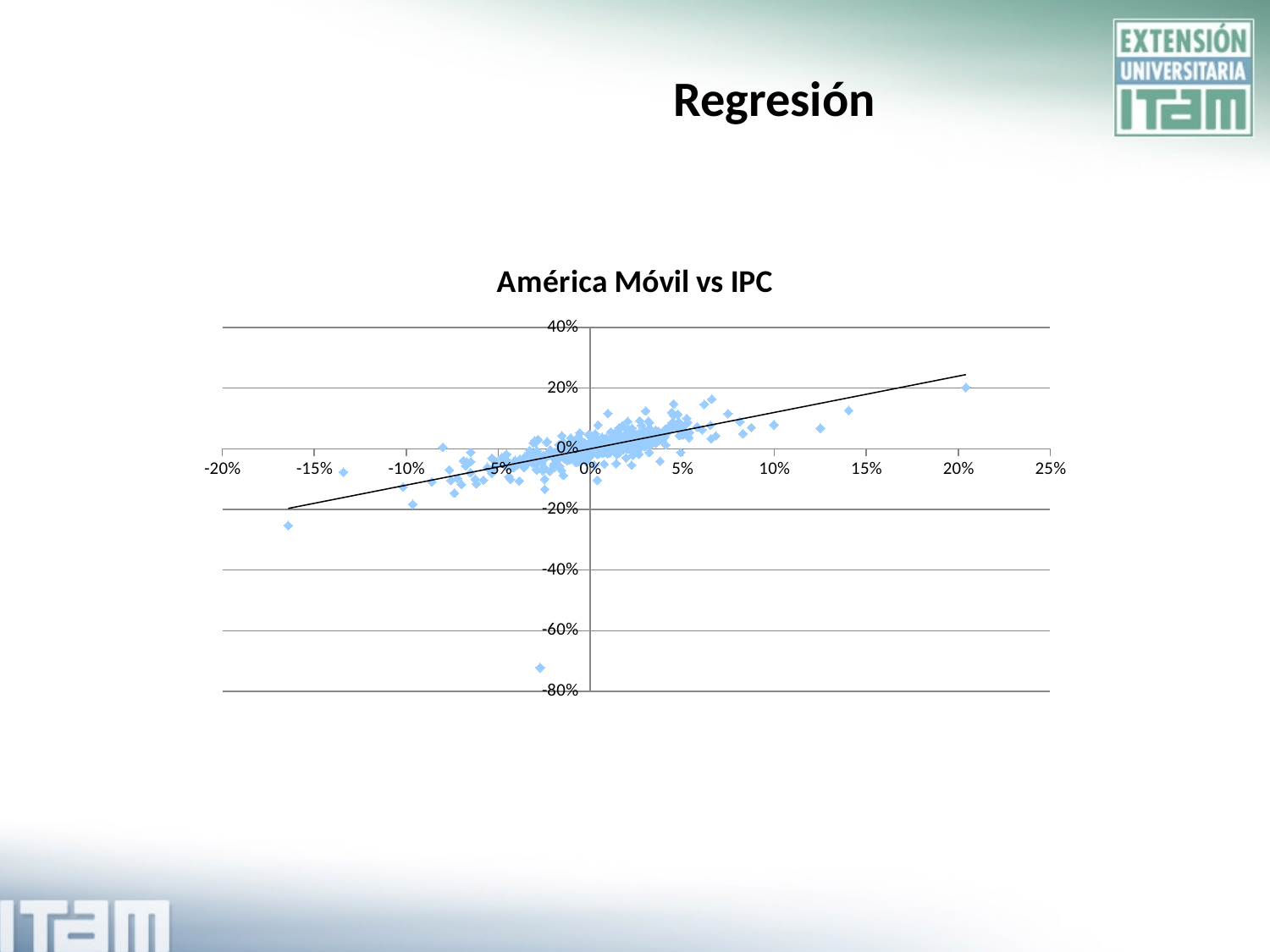
Is the y value of the highest plotted point greater or less than 40%? less What is the lowest value labelled on the vertical axis? -80% Does the fitted trend line rise or fall as the x-axis values increase? Rise Is the value of the trend line at x = 20% greater or less than 20%? greater Is the value of the trend line at x = -15% greater or less than 0%? less What kind of chart is shown on the slide? Scatter chart What is the title of the chart? América Móvil vs IPC